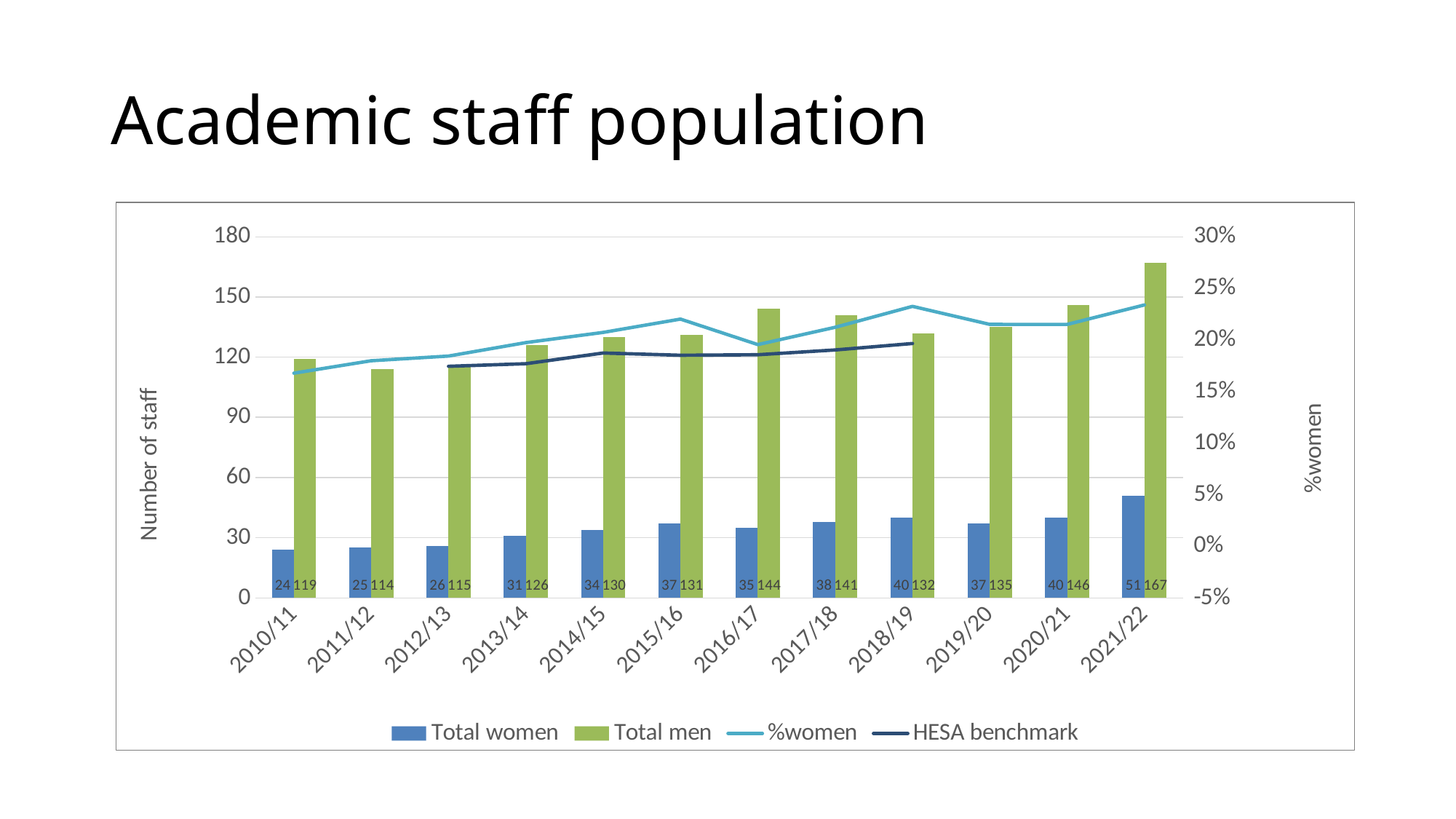
What kind of chart is this? Combined bar and line chart What is the value for Total women in 2018/19? 40 How many series does the legend list? 4 What is the label of the right-hand vertical axis? %women What is the value for Total women in 2013/14? 31 Which year has the lowest value for Total women? 2010/11 Which is larger, Total men in 2017/18 or Total men in 2018/19? Total men in 2017/18 How many years are shown on the x axis? 12 What is the value for Total men in 2021/22? 167 Which year has the highest value for Total men? 2021/22 Is the %women value for 2015/16 greater or less than 20%? greater What is the difference between Total men and Total women in 2016/17? 109